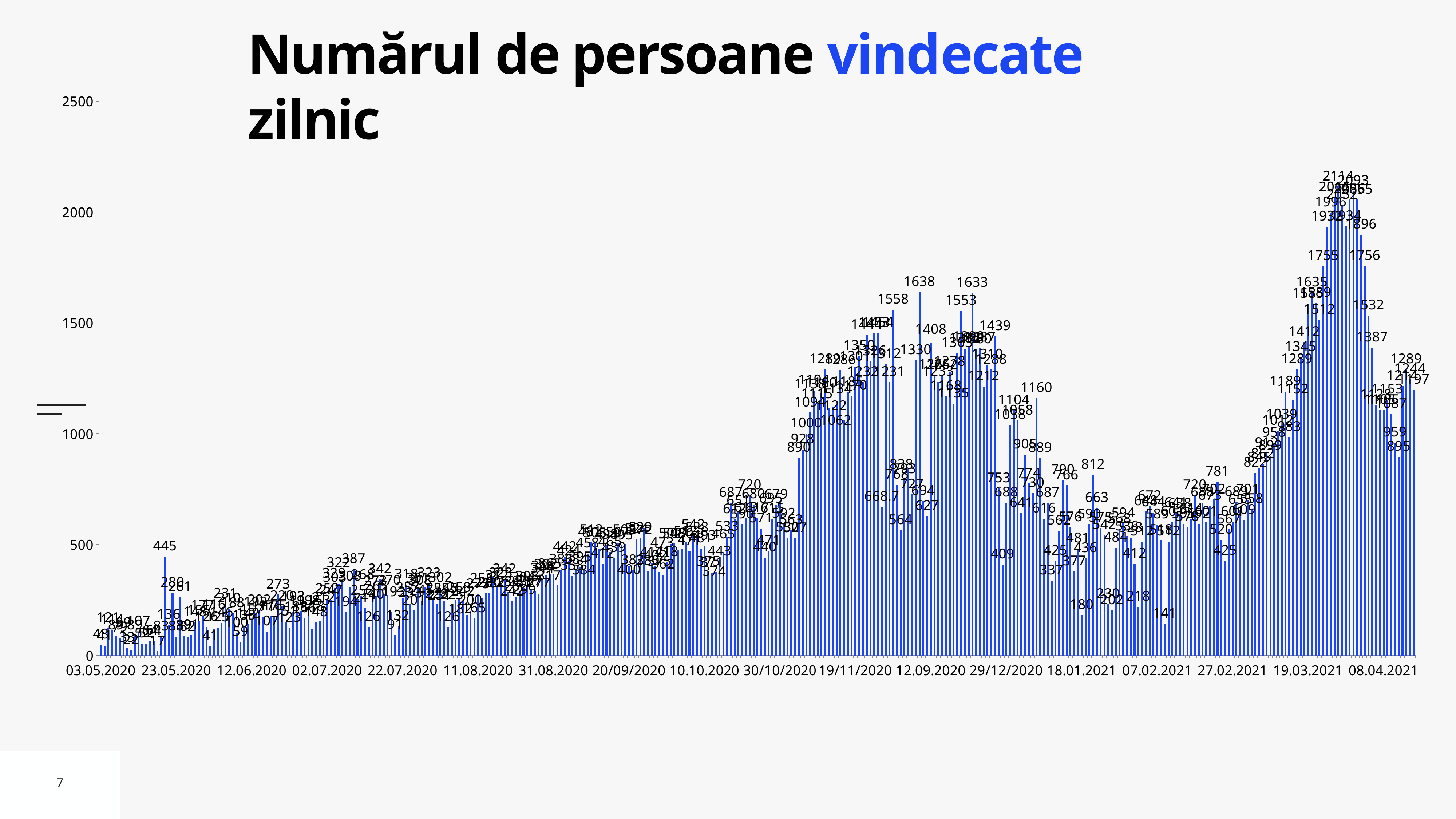
Is the tallest bar on the chart greater or less than 2000? greater What kind of chart is shown on the slide? bar chart What is the difference between the bar labelled 2114 and the bar labelled 1638? 476 What is the highest value labelled on the chart? 2114 What is the title of the chart? Numărul de persoane vindecate zilnic What is the highest tick value shown on the vertical axis? 2500 What is the last date label shown on the horizontal axis? 08.04.2021 Is the value of the first bar, at 03.05.2020, greater or less than 500? less Overall, do the values rise or fall from 03.05.2020 to 08.04.2021? rise Which is larger, the bar labelled 445 or the bar labelled 812? 812